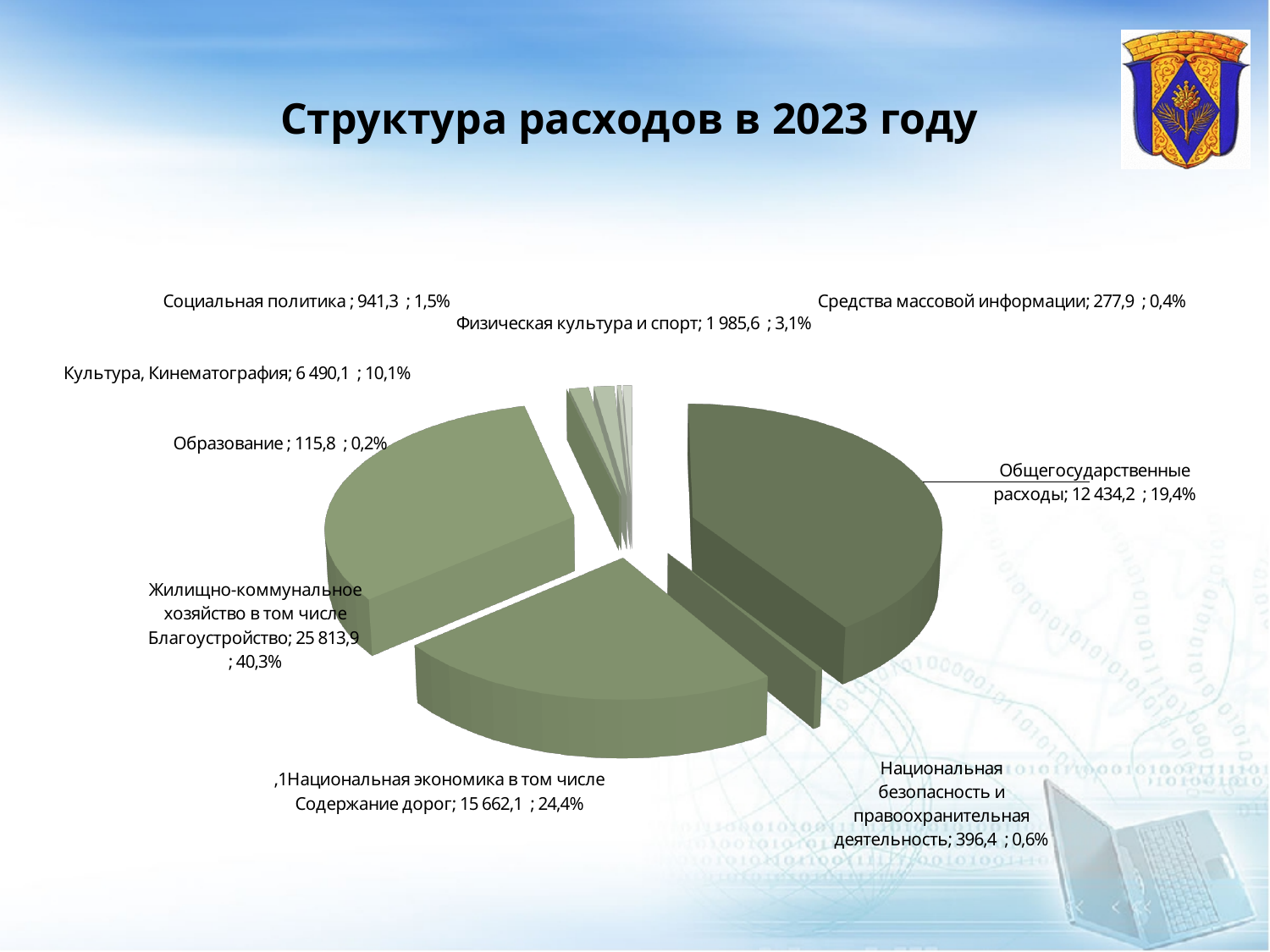
Which is larger: Национальная экономика в том числе Содержание дорог or Общегосударственные расходы? Национальная экономика в том числе Содержание дорог What kind of chart is shown on the slide? Pie chart How many categories (slices) does the pie chart have? 9 What is the value for Средства массовой информации? 277,9 What is the value for Культура, Кинематография? 6 490,1 What is the title of the chart? Структура расходов в 2023 году What is the value for Общегосударственные расходы? 12 434,2 What is the difference between the values for Социальная политика and Национальная безопасность и правоохранительная деятельность? 544,9 Which category has the smallest share of the pie? Образование What share of the pie does Жилищно-коммунальное хозяйство в том числе Благоустройство represent? 40,3% Which category has the largest share of the pie? Жилищно-коммунальное хозяйство в том числе Благоустройство What percentage is shown for Физическая культура и спорт? 3,1%